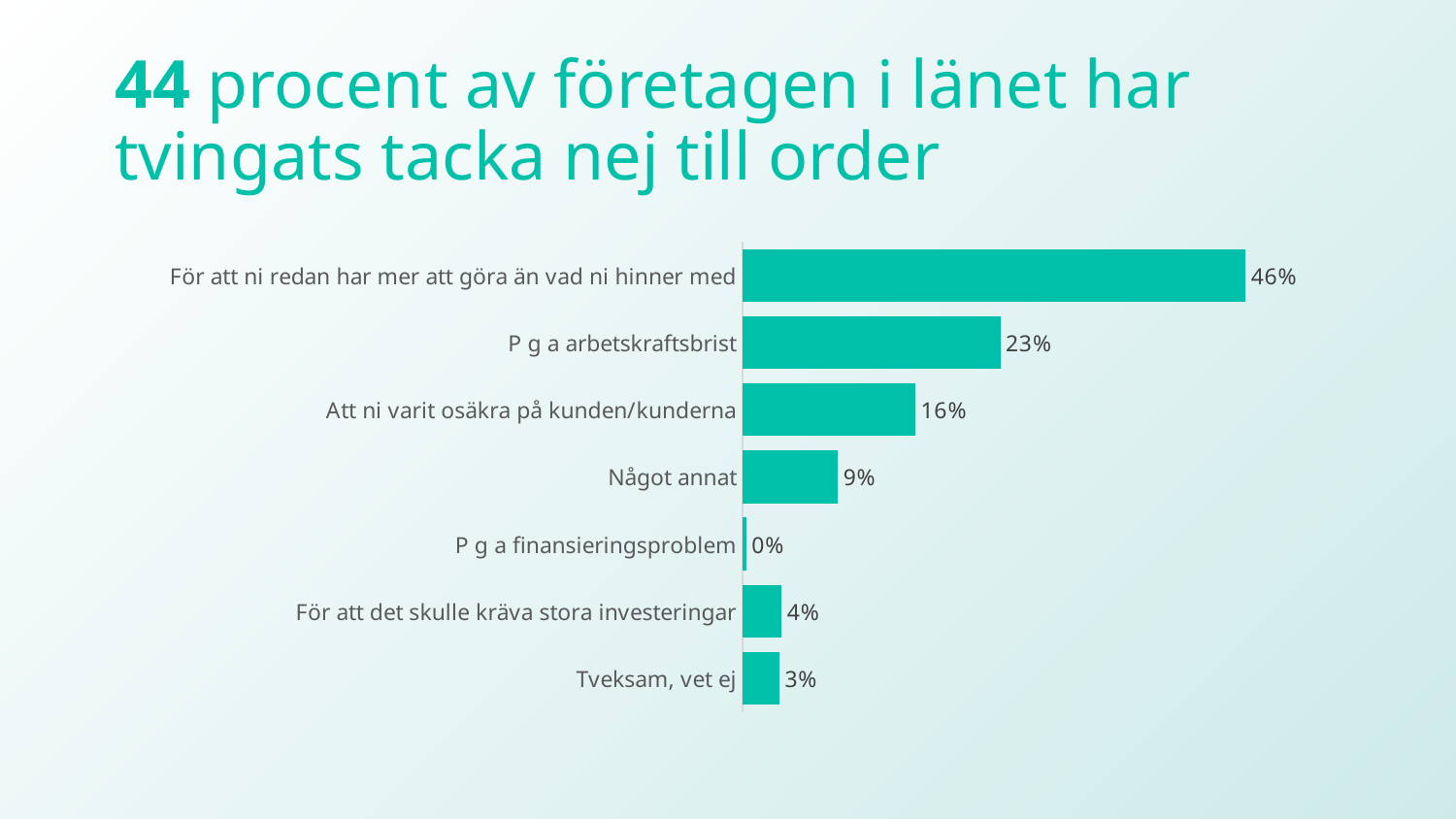
Which category has the highest value? För att ni redan har mer att göra än vad ni hinner med What is the value for "Att ni varit osäkra på kunden/kunderna"? 16% What is the value for "Tveksam, vet ej"? 3% What is the value for "P g a arbetskraftsbrist"? 23% What is the title of the slide? 44 procent av företagen i länet har tvingats tacka nej till order What is the difference between "Något annat" and "För att det skulle kräva stora investeringar"? 5% What kind of chart is shown on the slide? Bar chart Which is larger: "Något annat" or "Att ni varit osäkra på kunden/kunderna"? Att ni varit osäkra på kunden/kunderna Which category has the lowest value? P g a finansieringsproblem How many categories are shown in the chart? 7 What is the value for "P g a finansieringsproblem"? 0% What is the difference between "För att ni redan har mer att göra än vad ni hinner med" and "P g a arbetskraftsbrist"? 23%